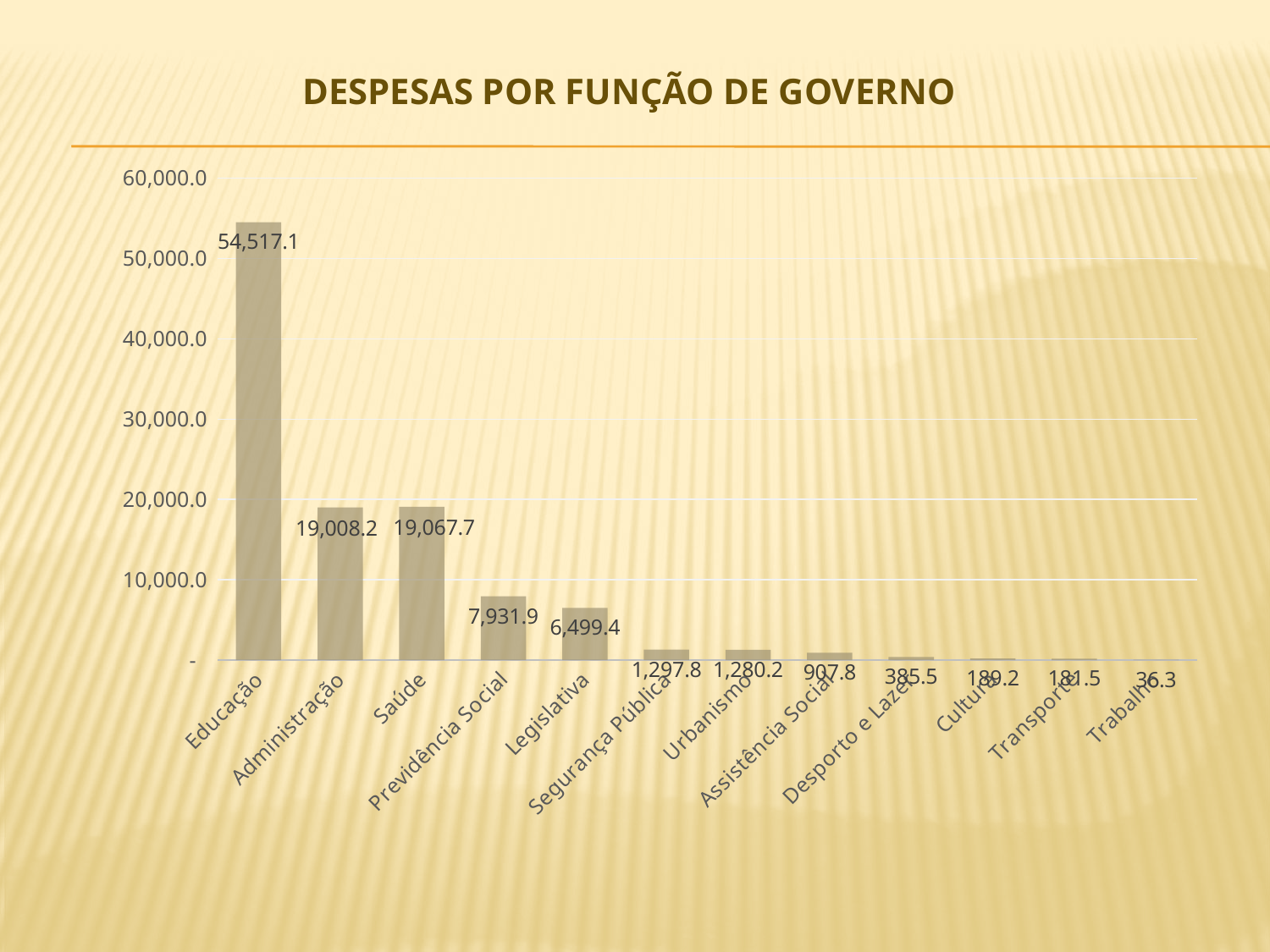
What is the value for Educação? 54,517.1 What is the value for Saúde? 19,067.7 What is the title of the chart? DESPESAS POR FUNÇÃO DE GOVERNO What is the difference between the values for Educação and Saúde? 35,449.4 Which category has the highest value? Educação How many categories are plotted in the chart? 12 What type of chart is shown on the slide? Bar chart What is the value for Segurança Pública? 1,297.8 Is the value for Legislativa greater or less than 10,000.0? less Which is larger, the value for Administração or the value for Saúde? Saúde What is the value for Previdência Social? 7,931.9 Which category has the lowest value? Trabalho